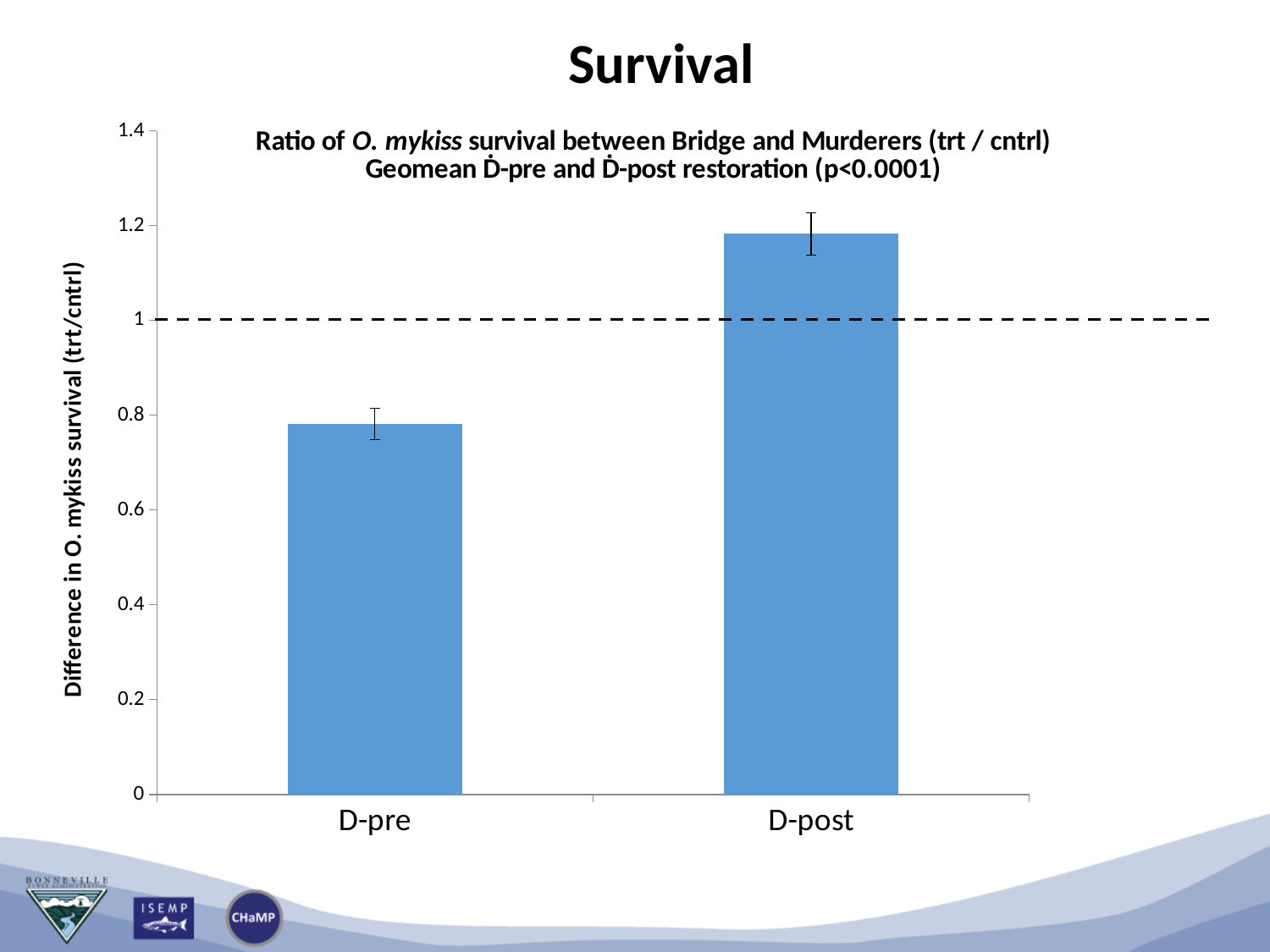
How many categories are plotted on the x axis? 2 What kind of chart is shown on the slide? bar chart Does the survival ratio rise or fall from D-pre to D-post? rise Is the bar for D-post taller or shorter than the bar for D-pre? taller Which category has the lower survival ratio? D-pre Is the value for D-post greater or less than 1.4? less Is the value for D-pre greater or less than 0.6? greater Is the value for D-pre greater or less than 1? less At what y-axis value is the horizontal dashed reference line drawn? 1 What is the label on the y axis of the chart? Difference in O. mykiss survival (trt/cntrl) Which category has the higher survival ratio, D-pre or D-post? D-post